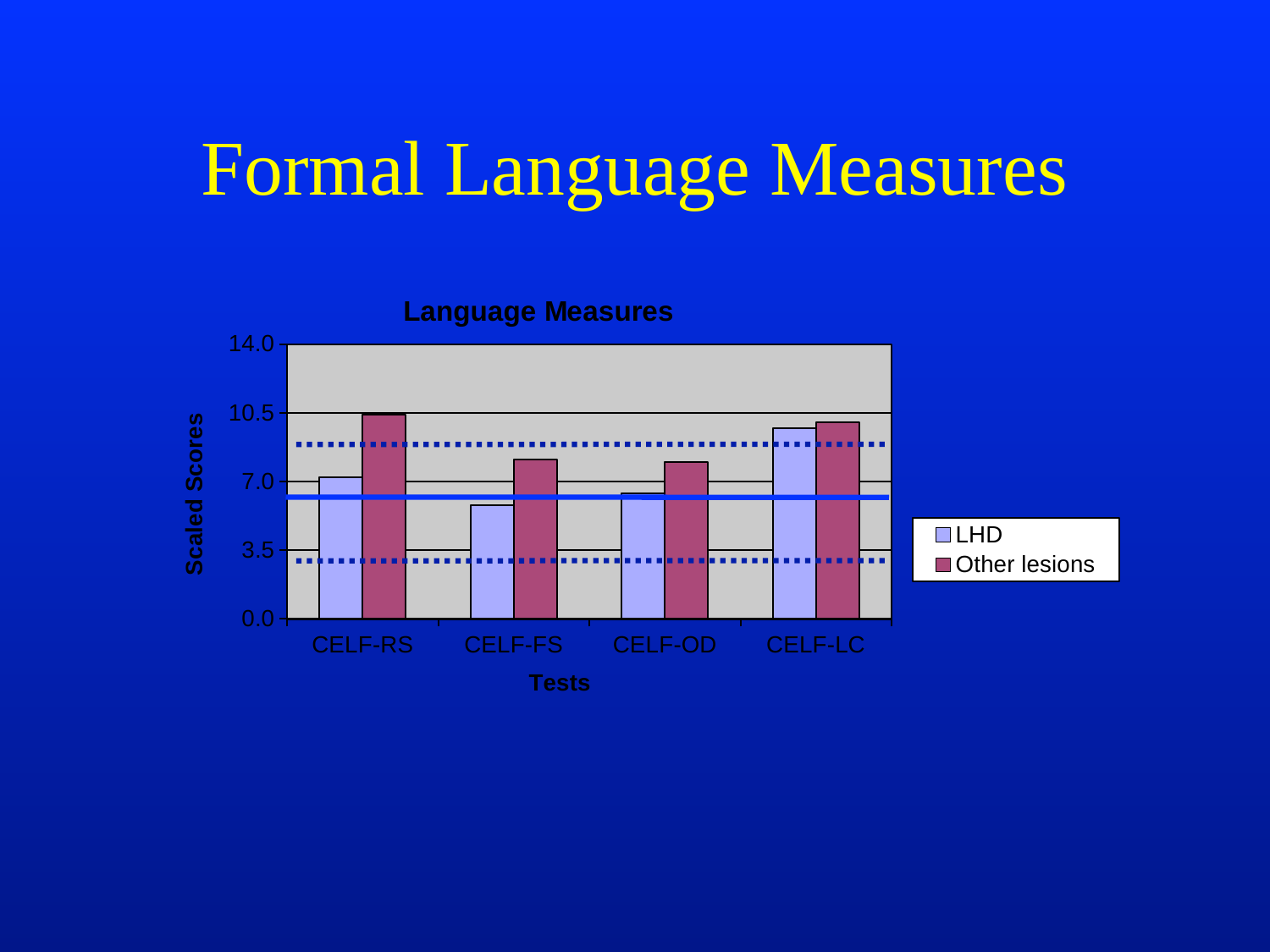
What is the title of the chart? Language Measures Is the LHD value for CELF-FS greater or less than 7.0? less What kind of chart is shown on the slide? bar chart For CELF-FS, which group has the higher score, LHD or Other lesions? Other lesions Is the Other lesions value for CELF-FS greater or less than 7.0? greater How many tests are shown on the x axis of the chart? 4 Which test has the lowest LHD score? CELF-FS How many series does the legend list? 2 For CELF-RS, which group has the higher score, LHD or Other lesions? Other lesions What is the label on the vertical axis of the chart? Scaled Scores Is the LHD value for CELF-LC greater or less than 7.0? greater Which test has the highest LHD score? CELF-LC